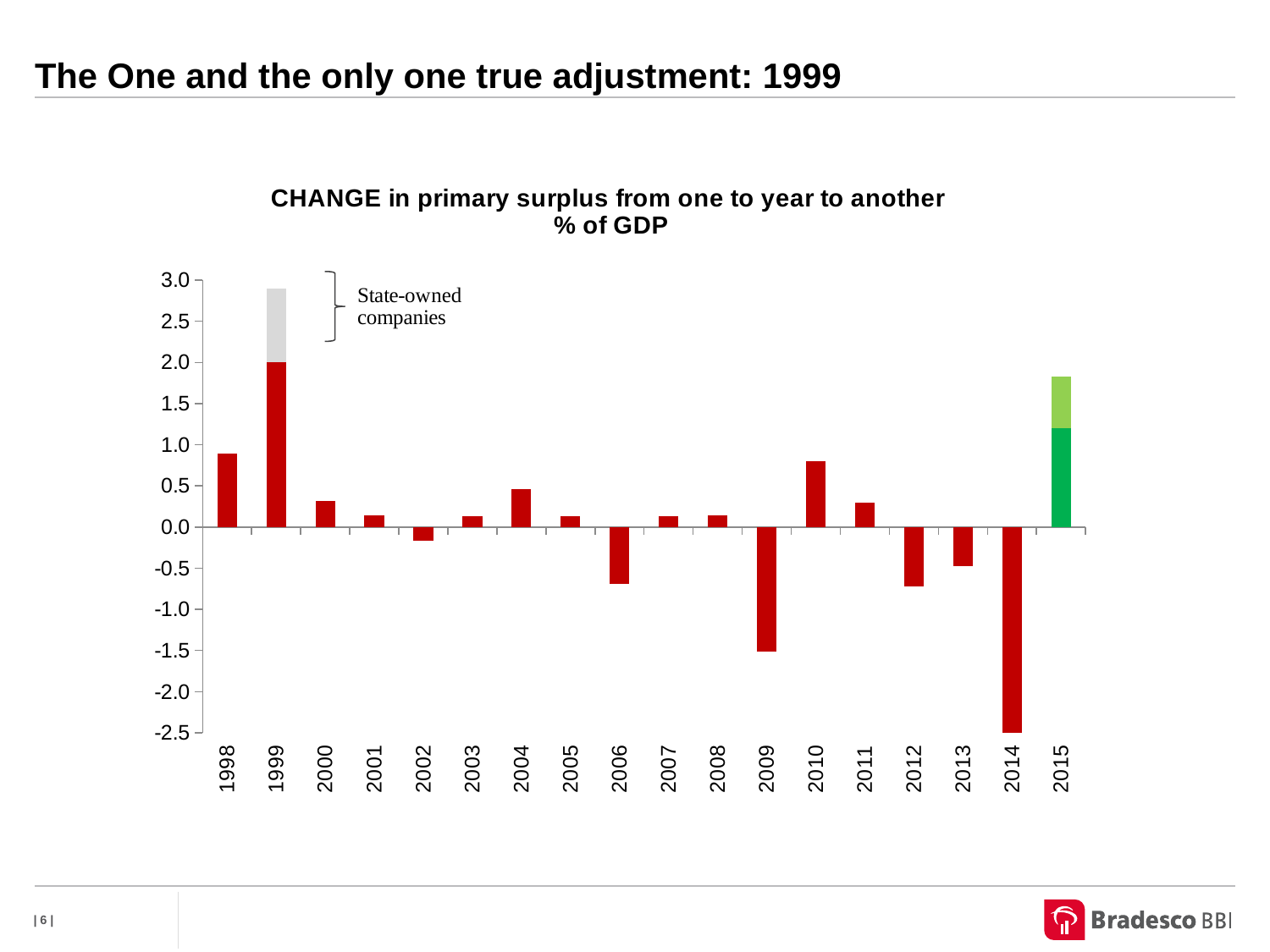
Is the value for 2014 greater or less than -2.0? less What is the unit given in the chart title? % of GDP What kind of chart is shown on the slide? bar chart Which year has the highest change in primary surplus? 1999 Which year has the lowest change in primary surplus? 2014 Is the value for 2006 greater or less than -0.5? less Is the value for 2009 greater or less than -1.0? less How many years are shown on the x axis of the chart? 18 What does the grey portion of the 1999 bar represent, according to the annotation? State-owned companies Which year has the larger value, 2004 or 2000? 2004